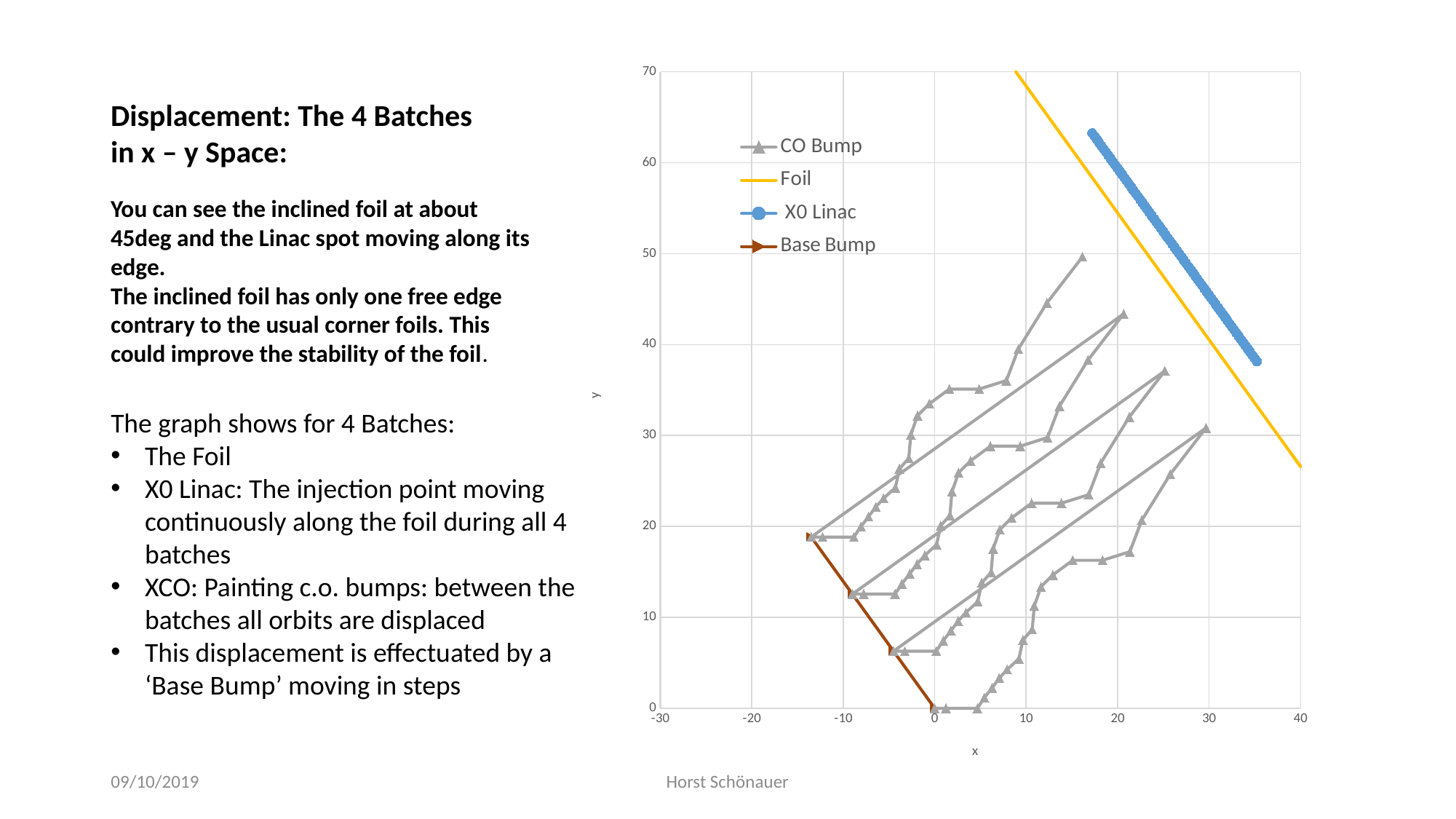
How many series does the chart legend list? 4 Is the y value of the highest point of the X0 Linac series greater or less than 60? greater Which series reaches higher y values, X0 Linac or Base Bump? X0 Linac Does the Base Bump series rise or fall as x increases? Fall Does the Foil line rise or fall as x increases? Fall What kind of chart is shown on the slide? Scatter (line) chart Is the y value of the lowest point of the X0 Linac series greater or less than 30? greater Is the y value of the Foil line at x = 40 greater or less than 30? less Does the X0 Linac series rise or fall as x increases? Fall What are the four series named in the chart legend? CO Bump, Foil, X0 Linac, Base Bump What colour is the Foil series drawn in? Yellow